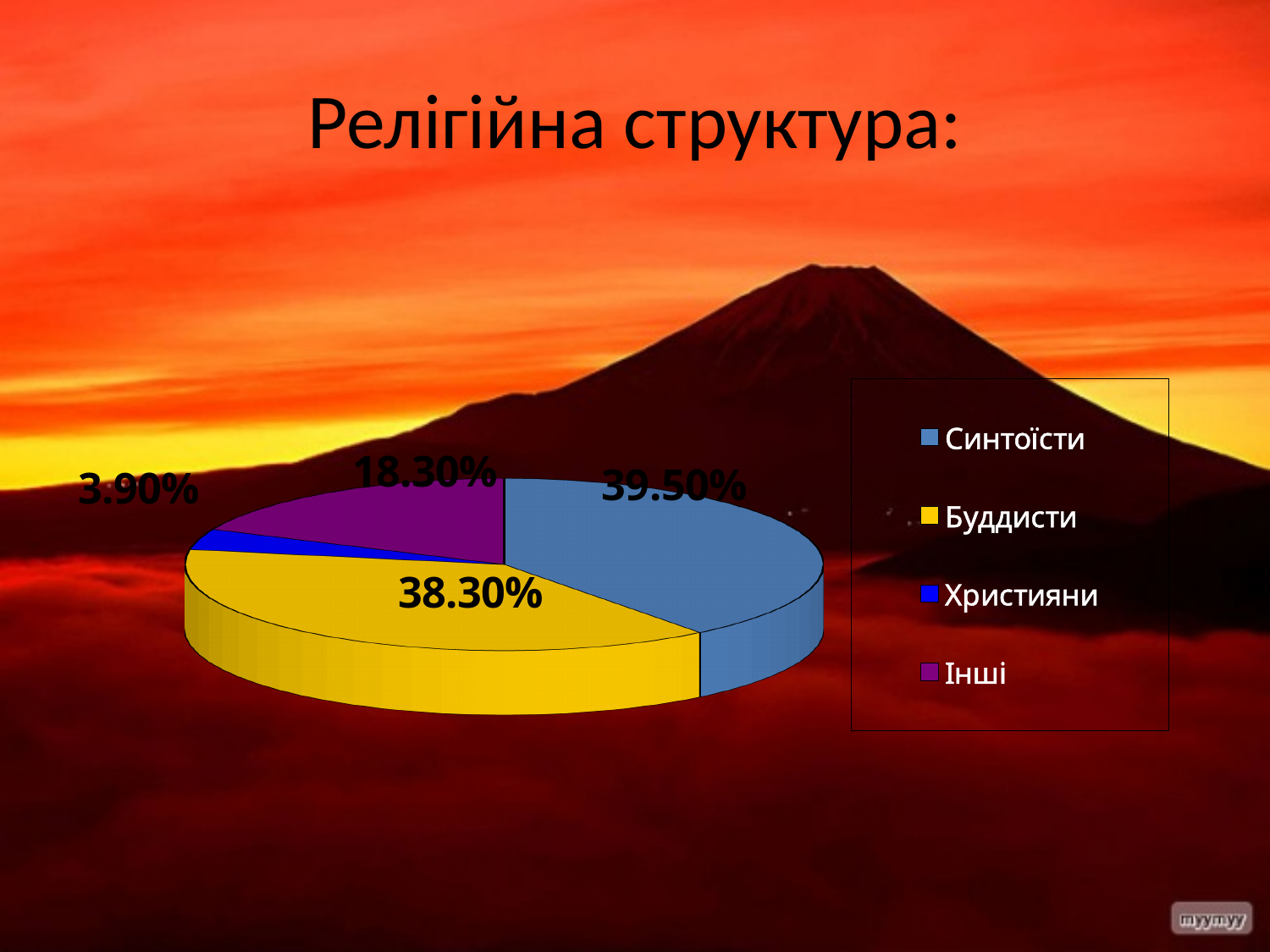
What kind of chart is shown on the slide? pie chart Which category has the smallest share of the pie? Християни What percentage of the pie is labelled for Інші? 18.30% Which category has the largest share of the pie? Синтоїсти Which is larger, the share for Інші or the share for Християни? Інші What percentage of the pie is labelled for Буддисти? 38.30% What percentage of the pie is labelled for Християни? 3.90% What is the difference in percentage points between the Синтоїсти share and the Буддисти share? 1.20 What percentage of the pie is labelled for Синтоїсти? 39.50% What is the title of the chart on the slide? Релігійна структура: What colour is the slice for Інші? purple How many categories does the legend list? 4